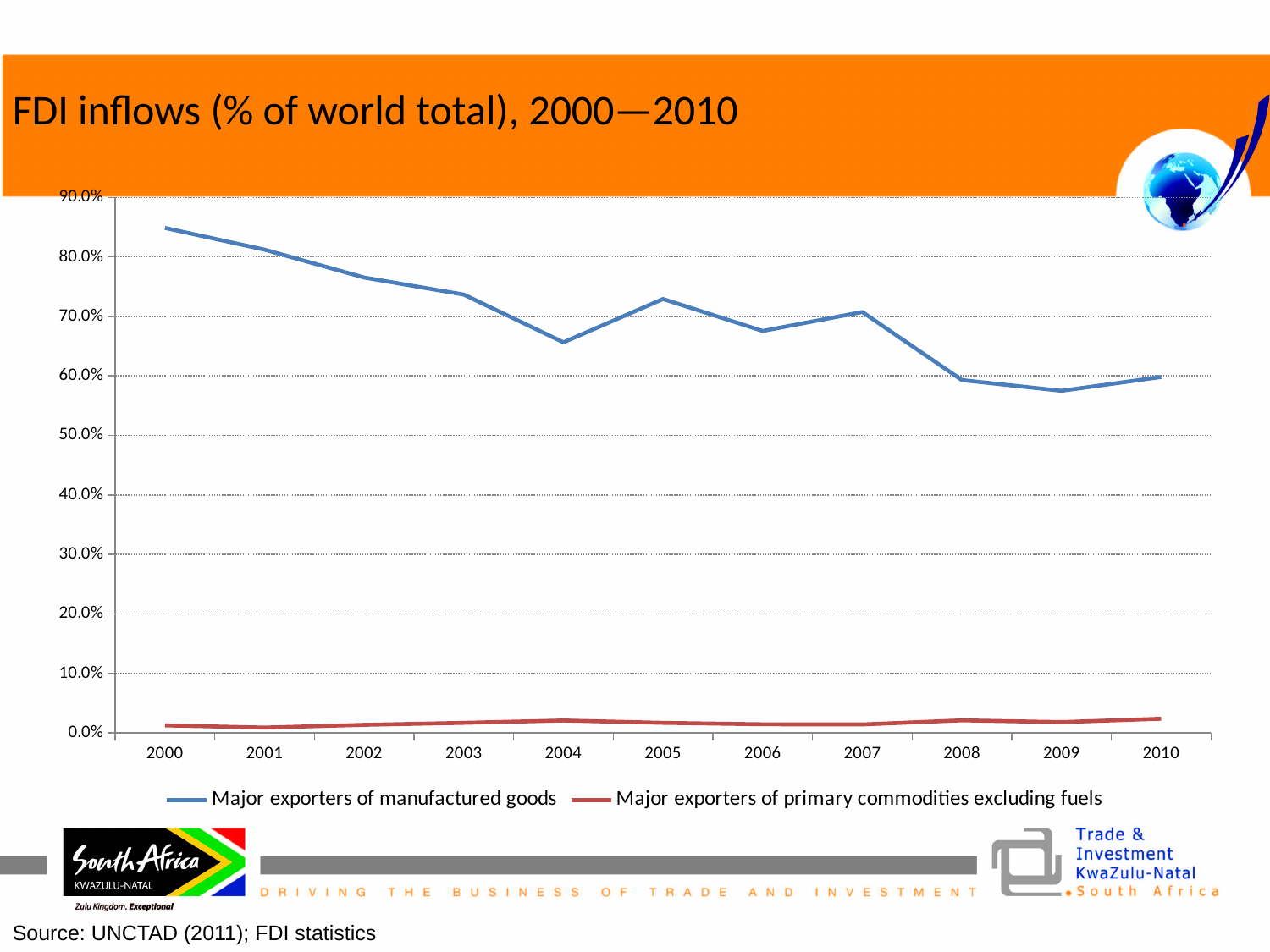
Which series has the higher values throughout the period: Major exporters of manufactured goods or Major exporters of primary commodities excluding fuels? Major exporters of manufactured goods Is the value for Major exporters of primary commodities excluding fuels in 2010 greater or less than 10.0%? less What kind of chart is shown on the slide? line chart How many years are plotted along the x axis? 11 In which year is the value for Major exporters of manufactured goods highest? 2000 What is the title of the chart? FDI inflows (% of world total), 2000—2010 Overall, does the line for Major exporters of manufactured goods rise or fall from 2000 to 2010? fall How many series does the legend list? 2 Is the value for Major exporters of manufactured goods in 2004 greater or less than 70.0%? less Is the value for Major exporters of manufactured goods in 2000 greater or less than 80.0%? greater Which is larger for Major exporters of manufactured goods: the value in 2004 or the value in 2005? 2005